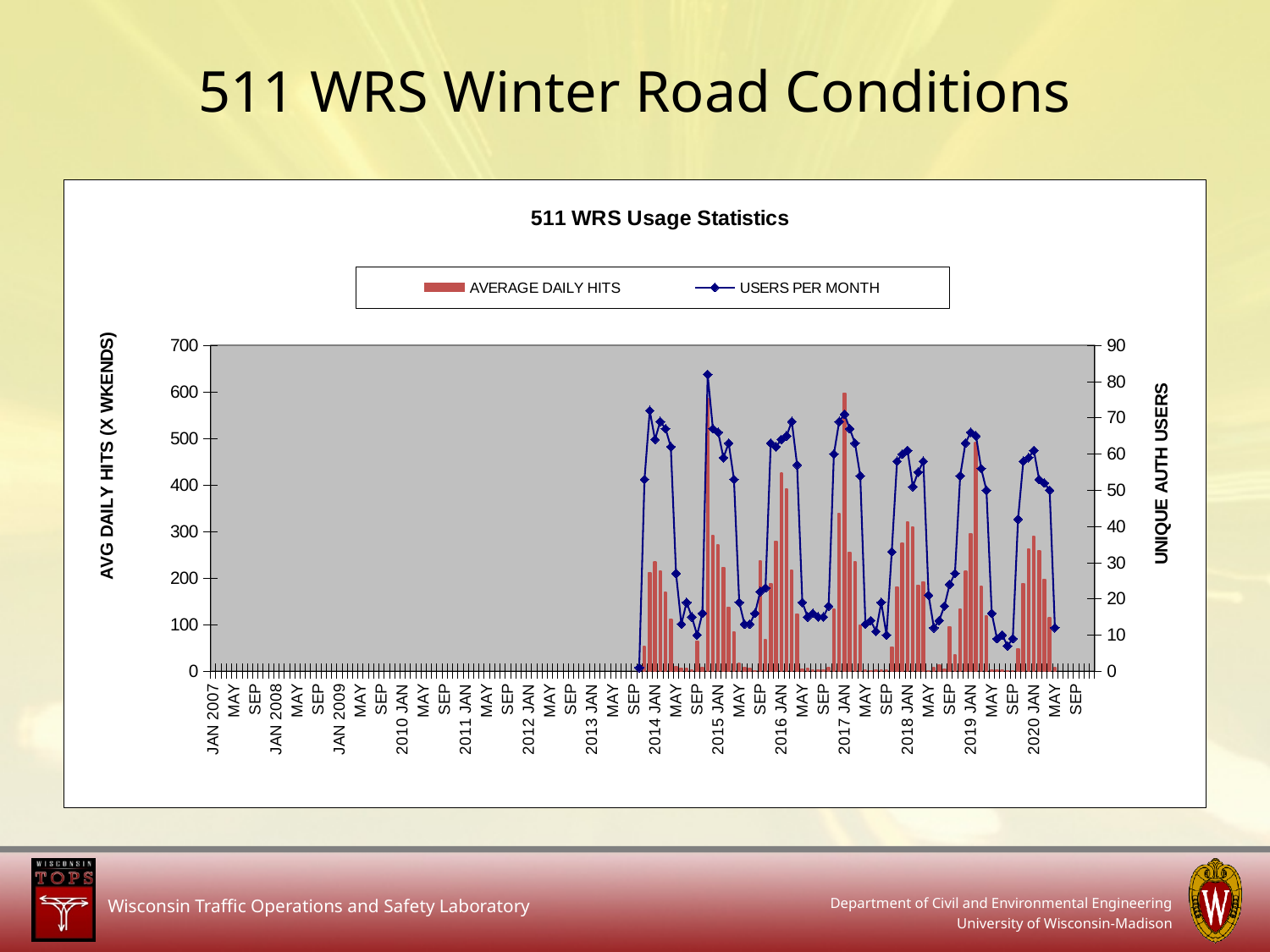
Is the AVERAGE DAILY HITS value at MAY 2015 greater or less than 200? less Is the highest point of the USERS PER MONTH line greater or less than 70? greater What kind of chart is shown? Combination bar and line chart What is the title of the chart? 511 WRS Usage Statistics Is the USERS PER MONTH value at JAN 2016 greater or less than 50? greater Which peak of the USERS PER MONTH line is higher, the one in late 2014 or the one in early 2017? late 2014 What is the title of the right-hand vertical axis? UNIQUE AUTH USERS In which year does the USERS PER MONTH line reach its highest point? 2014 How many series does the chart legend list? 2